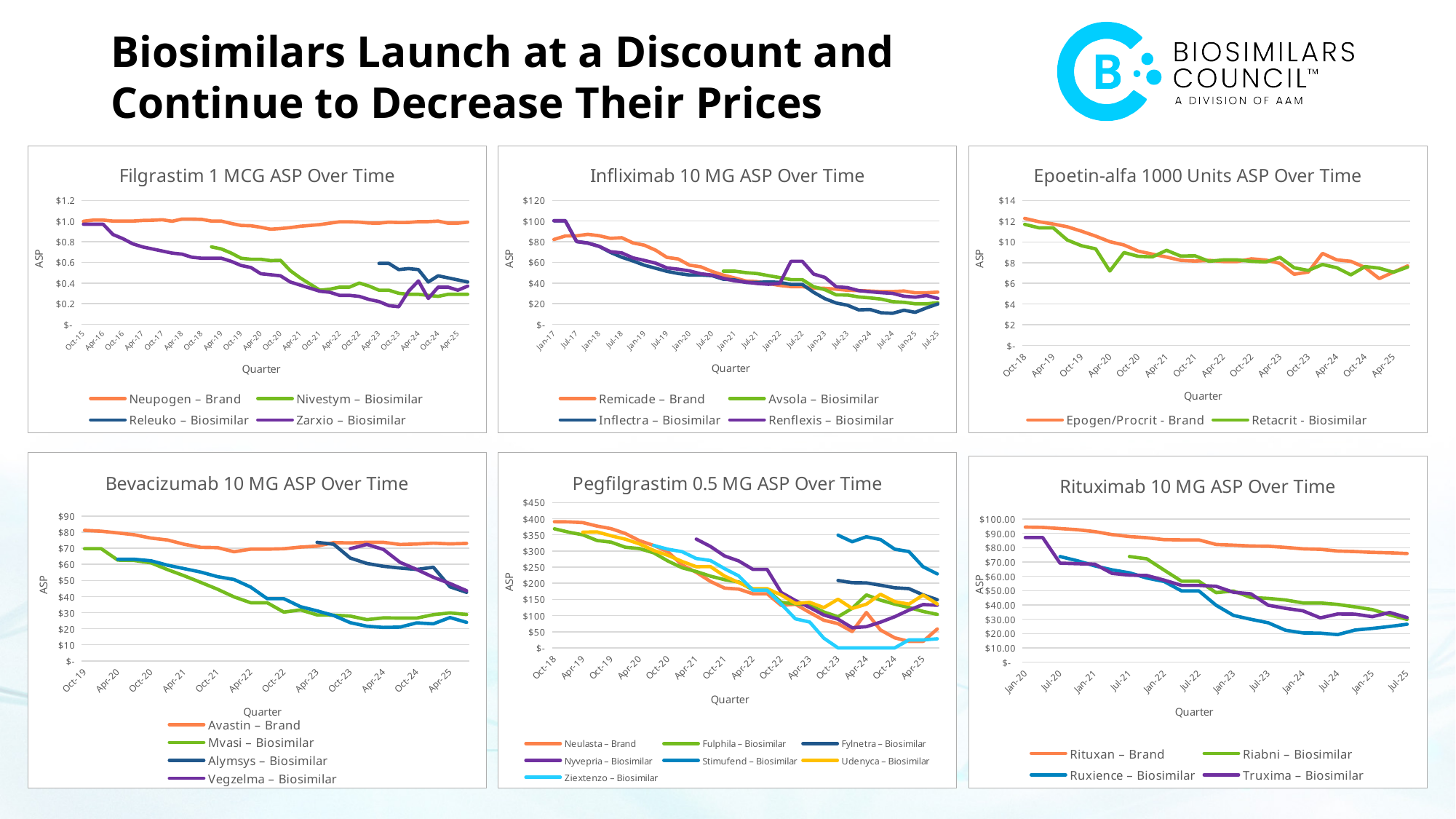
How many series does the legend of the "Pegfilgrastim 0.5 MG ASP Over Time" chart list? 7 How many series does the legend of the "Epoetin-alfa 1000 Units ASP Over Time" chart list? 2 In the "Rituximab 10 MG ASP Over Time" chart, is the value for Ruxience – Biosimilar at Jul-24 greater or less than $30? less In the "Bevacizumab 10 MG ASP Over Time" chart, which series has the higher value at Apr-25, Avastin – Brand or Mvasi – Biosimilar? Avastin – Brand In the "Infliximab 10 MG ASP Over Time" chart, is the value for Inflectra – Biosimilar at Jul-24 greater or less than $20? less In the "Infliximab 10 MG ASP Over Time" chart, which series has the higher value at Jan-17, Remicade – Brand or Renflexis – Biosimilar? Renflexis – Biosimilar How many charts are shown on the slide? 6 What kind of chart is the "Filgrastim 1 MCG ASP Over Time" chart? Line chart In the "Rituximab 10 MG ASP Over Time" chart, do the values for Rituxan – Brand rise or fall from Jan-20 to Jul-25? fall In the "Bevacizumab 10 MG ASP Over Time" chart, is the value for Mvasi – Biosimilar at Apr-25 greater or less than $40? less